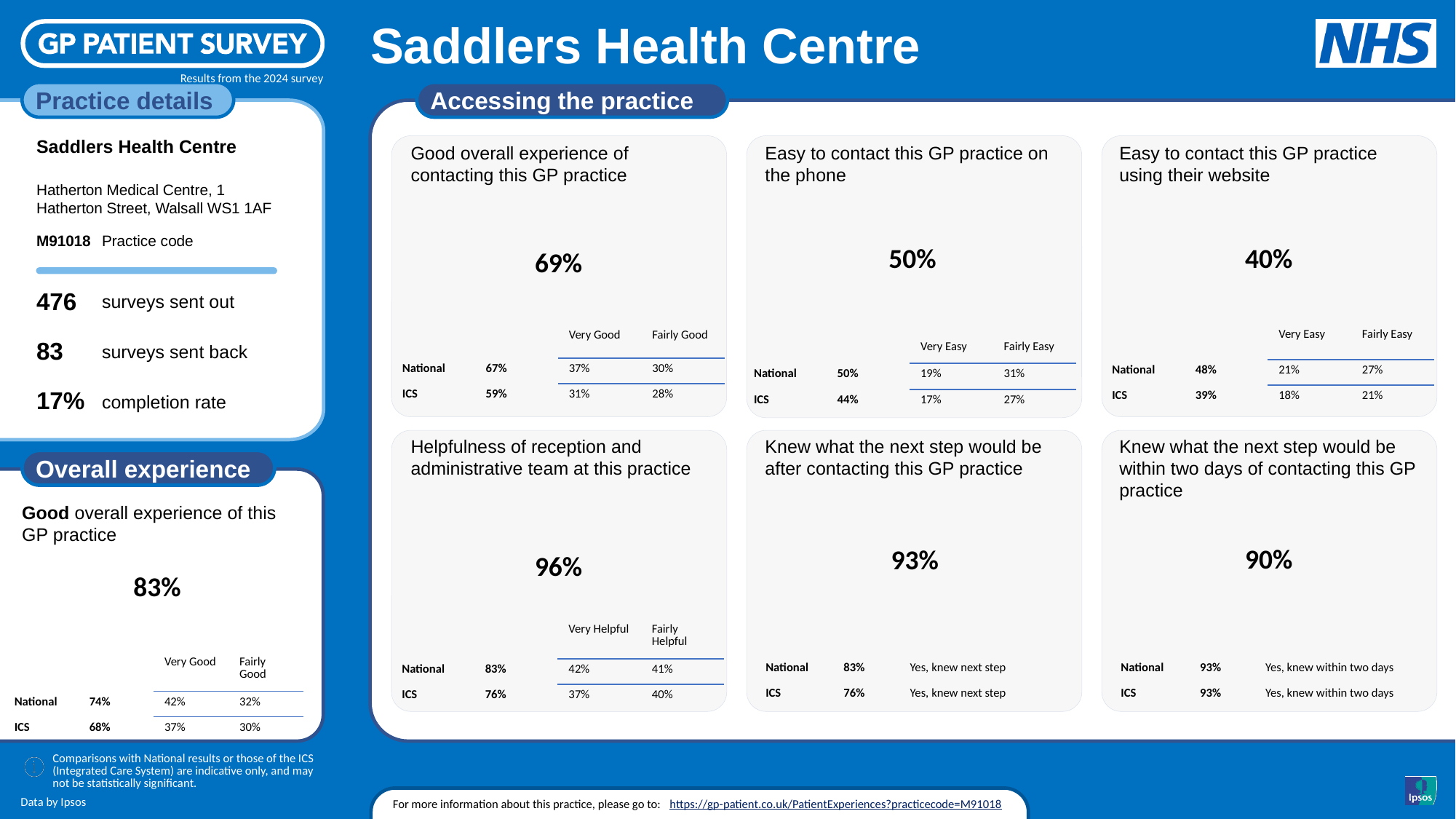
In the 'Good overall experience of contacting this GP practice' panel, what is the practice's headline percentage? 69% In the 'Helpfulness of reception and administrative team at this practice' panel, what is the practice's headline percentage? 96% Among the six panels under 'Accessing the practice', which has the highest headline percentage? Helpfulness of reception and administrative team at this practice (96%) Which is higher for this practice: the headline value for being easy to contact on the phone or the headline value for being easy to contact using their website? On the phone (50%) How many result panels are shown under the 'Accessing the practice' heading? 6 In the 'Easy to contact this GP practice on the phone' panel, what is the practice's headline percentage? 50% In the 'Easy to contact this GP practice on the phone' panel, what is the ICS value? 44% In the 'Easy to contact this GP practice using their website' panel, what is the practice's headline percentage? 40% Among the six panels under 'Accessing the practice', which has the lowest headline percentage? Easy to contact this GP practice using their website (40%) In the 'Knew what the next step would be within two days of contacting this GP practice' panel, what is the practice's headline percentage? 90% In the 'Good overall experience of this GP practice' panel under Overall experience, what is the National value? 74% In the 'Good overall experience of this GP practice' panel, how many percentage points higher is the practice's 83% than the National 74%? 9 percentage points